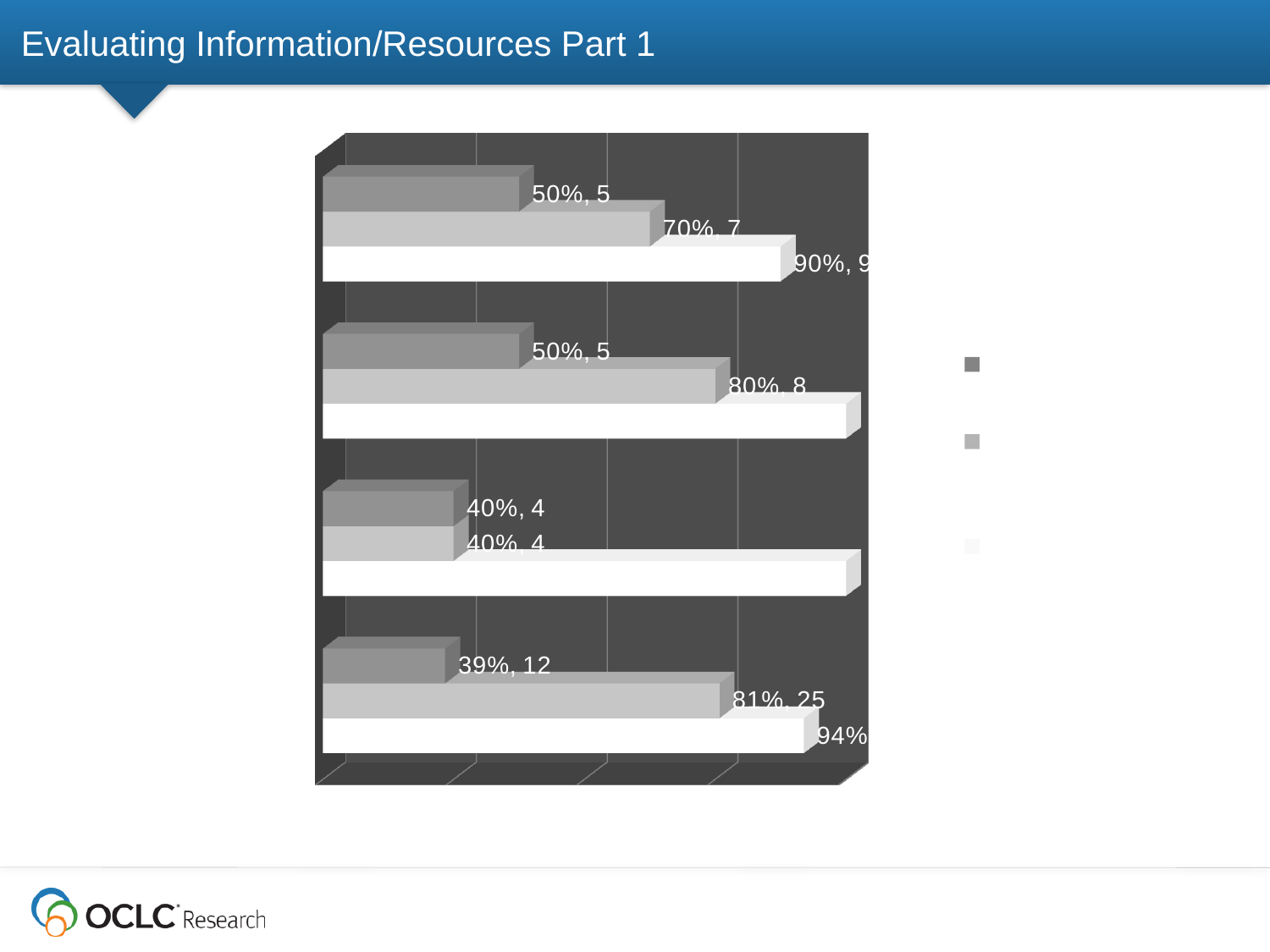
How many groups of bars does the chart show? 4 In the top group, what is the difference in percentage between the white bar and the dark grey bar? 40% What is the data label on the light grey bar in the second group from the top? 80%, 8 What is the title of the slide containing the chart? Evaluating Information/Resources Part 1 What is the data label on the dark grey bar in the top group? 50%, 5 In the bottom group, what is the difference in count between the light grey bar and the dark grey bar? 13 What kind of chart is shown on the slide? Bar chart In the top group, which is longer: the dark grey bar or the light grey bar? The light grey bar What is the data label on the white bar in the bottom group? 94% How many series does the legend list? 3 What is the data label on the light grey bar in the bottom group? 81%, 25 What is the data label on the white bar in the top group? 90%, 9